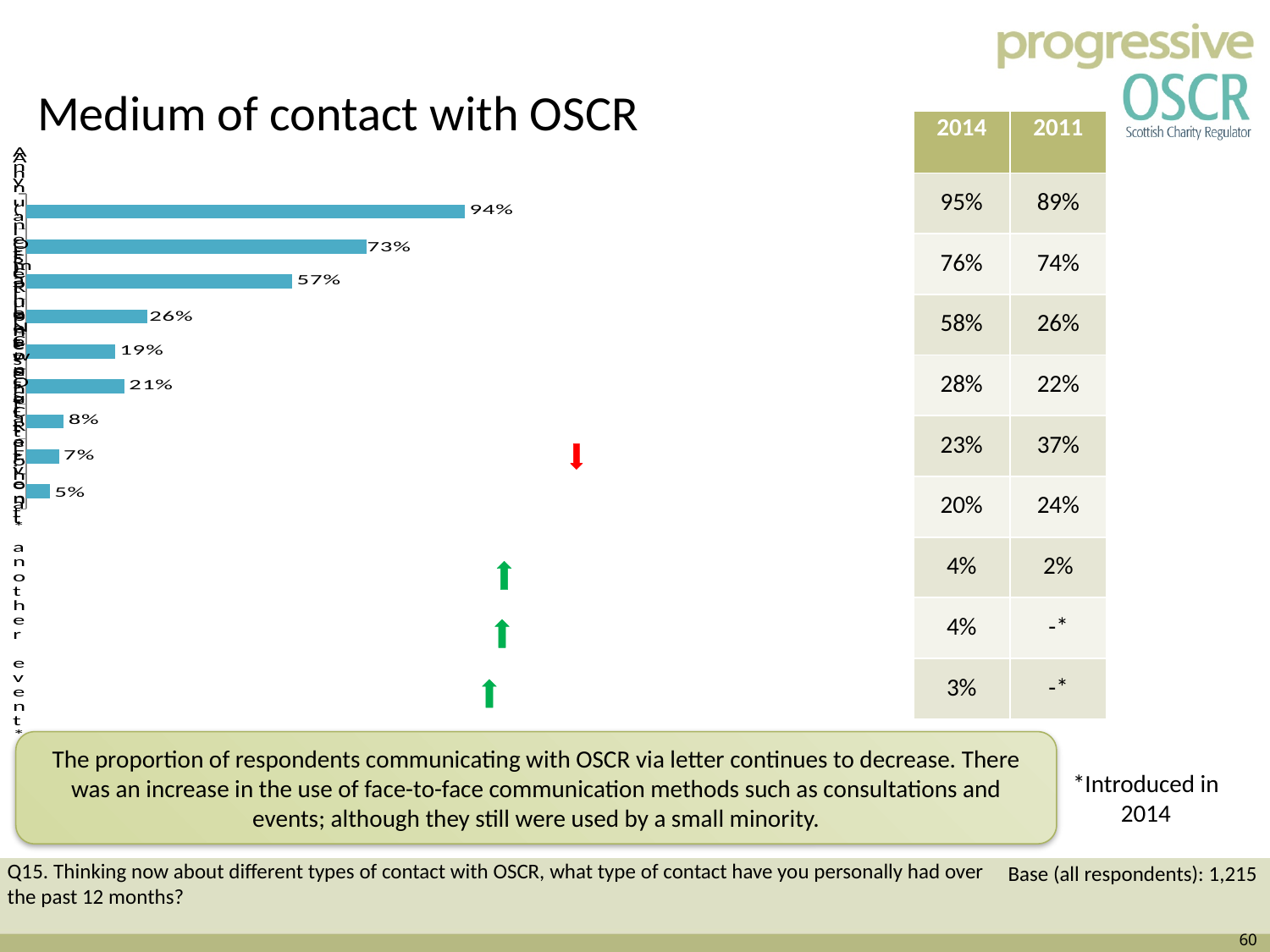
What is the title of the slide containing the chart? Medium of contact with OSCR What is the highest value labelled on any bar in the chart? 94% What is the value shown on the bottom bar of the chart? 5% What is the value shown on the third bar from the top of the chart? 57% What is the lowest value labelled on any bar in the chart? 5% What kind of chart is shown on the slide? bar chart Which is larger, the fifth bar from the top (19%) or the sixth bar from the top (21%)? the sixth bar (21%) What is the difference between the top bar (94%) and the second bar (73%)? 21% How many bars are plotted in the chart? 9 What is the value shown on the top bar of the chart? 94% What is the difference between the fourth bar from the top (26%) and the bottom bar (5%)? 21% What is the value shown on the second bar from the top of the chart? 73%